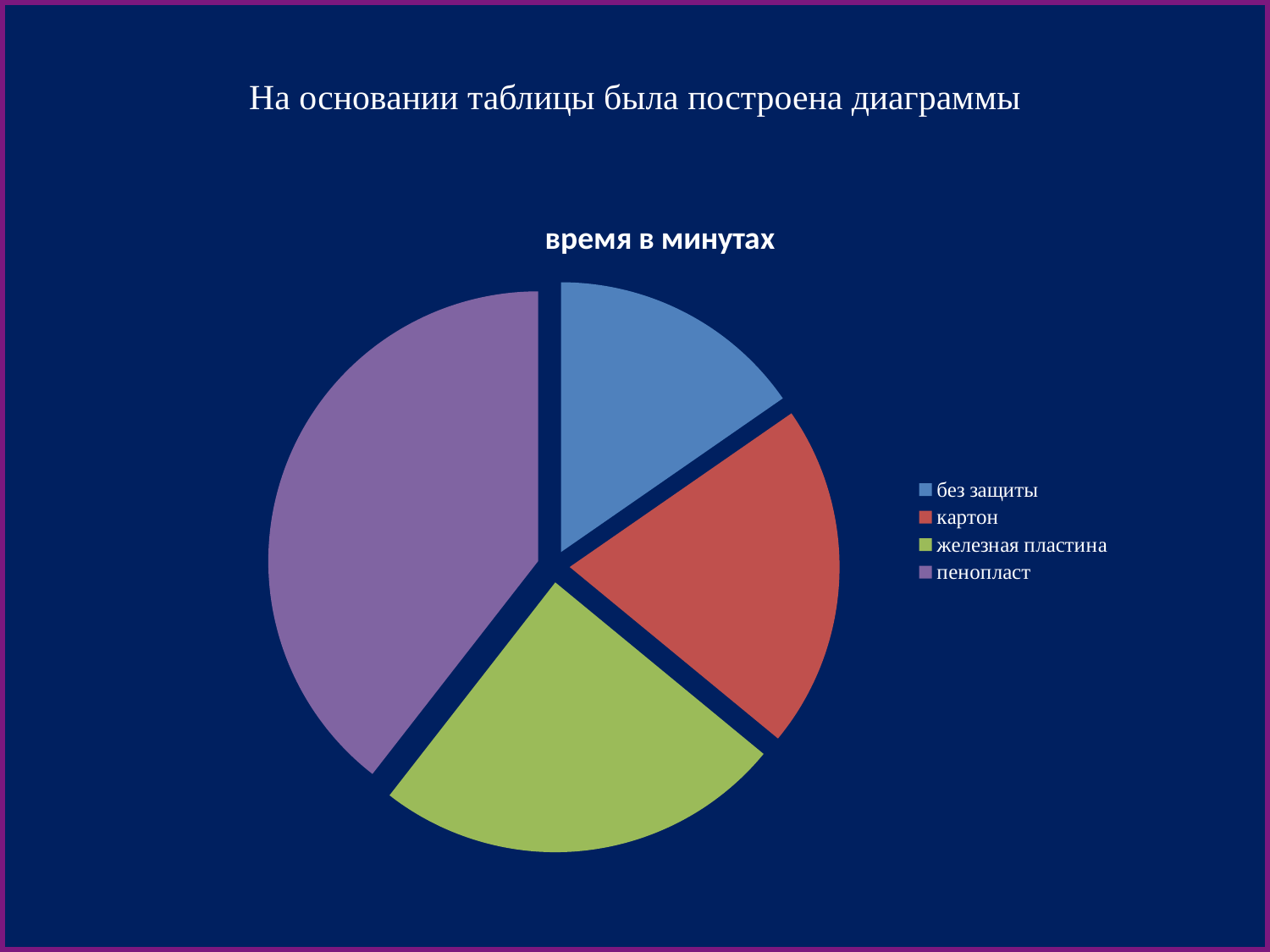
Which category has the largest slice of the pie? пенопласт Which slice is larger, пенопласт or железная пластина? пенопласт Which category has the smallest slice of the pie? без защиты Which slice is larger, пенопласт or картон? пенопласт Which colour represents картон in the legend? red How many slices does the pie chart have? 4 How many entries does the legend list? 4 Which slice is larger, железная пластина or без защиты? железная пластина What kind of chart is shown on the slide? pie chart What is the title of the chart? время в минутах